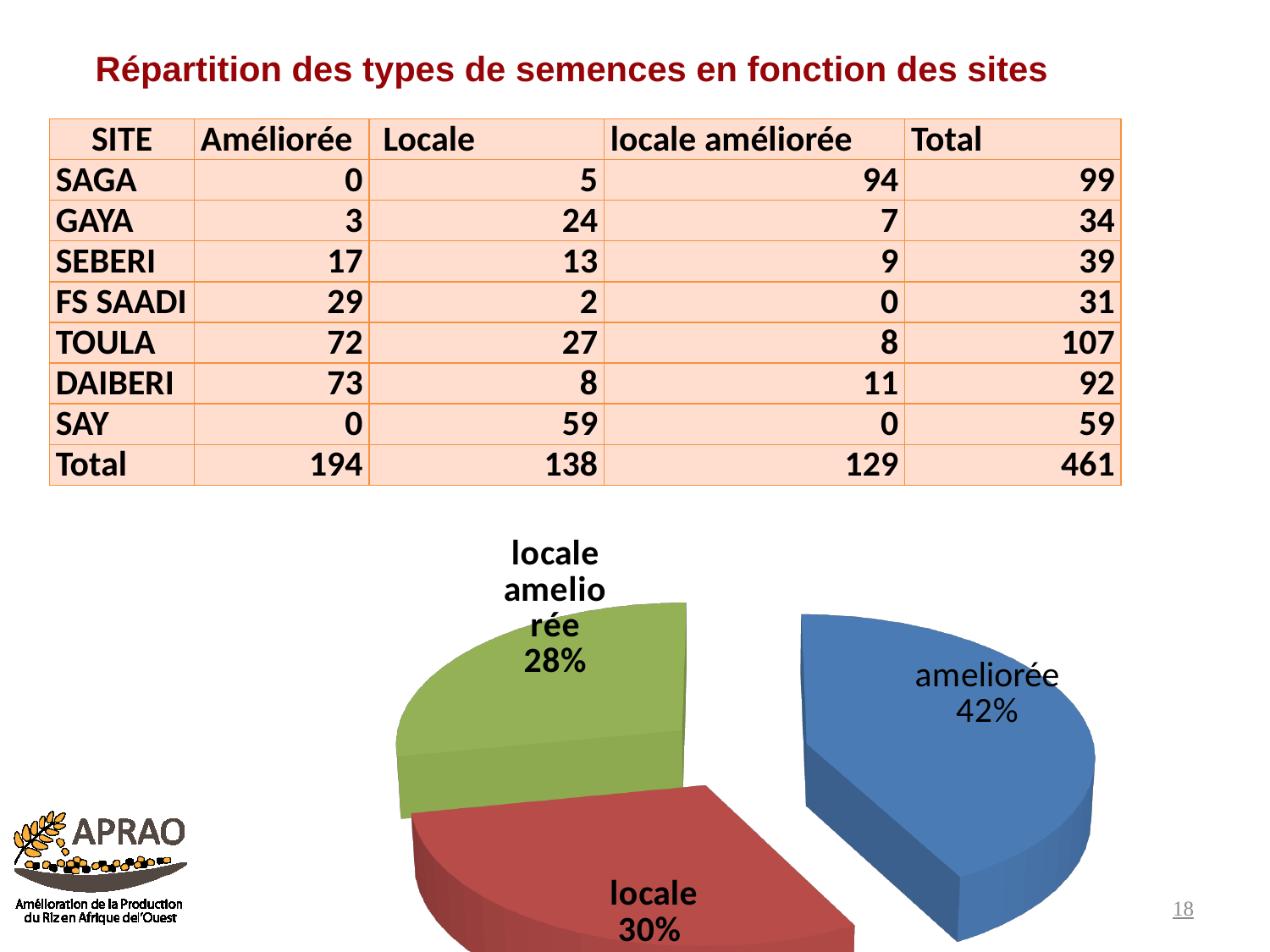
Which slice of the pie chart is the largest? ameliorée What kind of chart is shown on the slide? pie chart What share of the pie does the 'locale ameliorée' slice represent? 28% Which slice of the pie chart is the smallest? locale ameliorée What share of the pie does the 'ameliorée' slice represent? 42% Which is larger in the pie chart, the 'ameliorée' slice or the 'locale ameliorée' slice? ameliorée What is the difference in percentage points between the 'ameliorée' slice and the 'locale' slice? 12 What is the difference in percentage points between the 'locale' slice and the 'locale ameliorée' slice? 2 What colour is the 'locale' slice in the pie chart? red How many slices does the pie chart have? 3 What colour is the 'ameliorée' slice in the pie chart? blue What share of the pie does the 'locale' slice represent? 30%